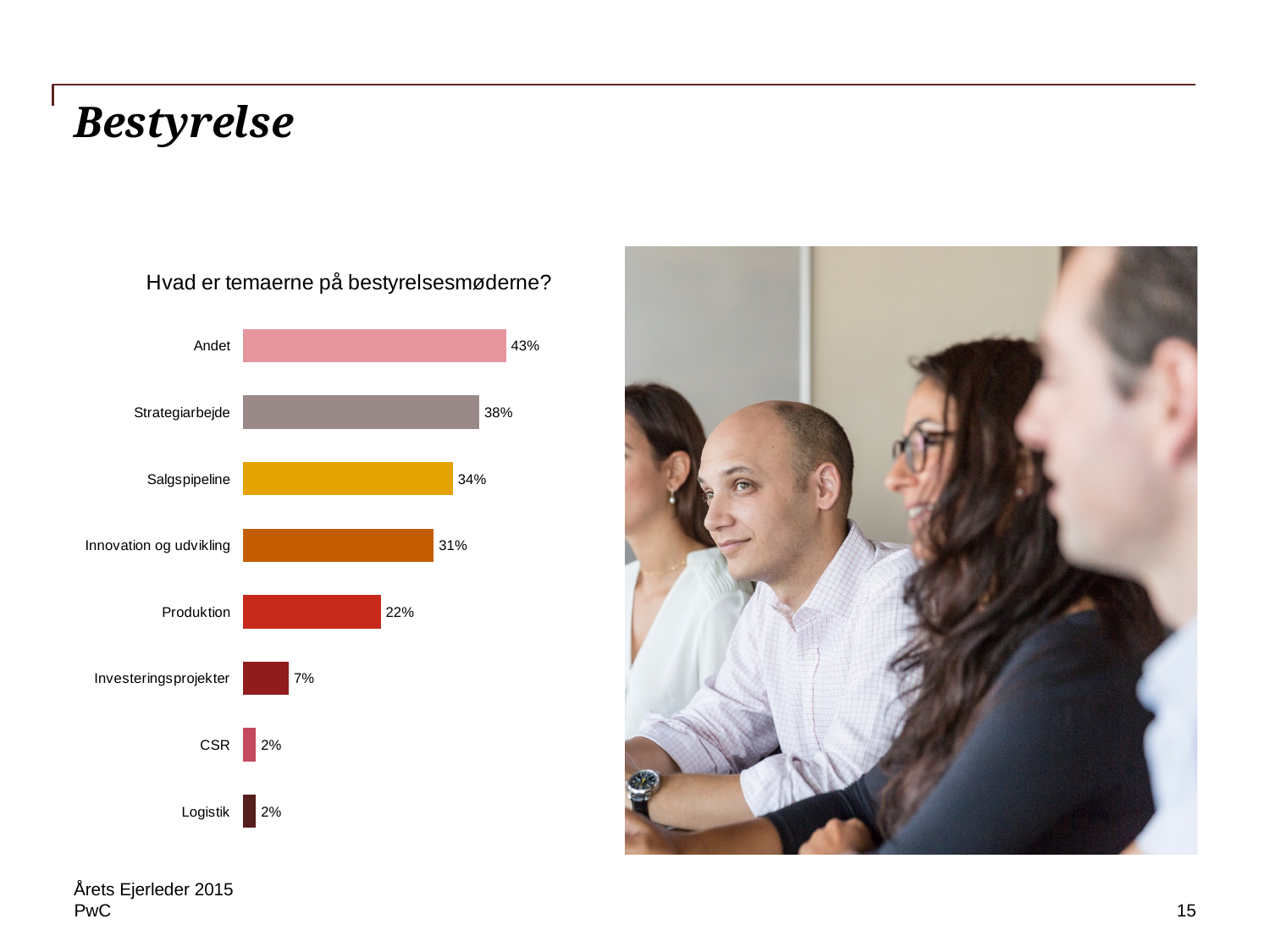
Which category has the highest value? Andet Which two categories share the lowest value of 2%? CSR and Logistik What is the difference between the values for Innovation og udvikling and Produktion? 9% How many categories are shown in the chart? 8 What kind of chart is shown on the slide? Bar chart What is the title of the chart? Hvad er temaerne på bestyrelsesmøderne? What is the value for Salgspipeline? 34% What is the difference between the values for Andet and Salgspipeline? 9% What is the value for Strategiarbejde? 38% What is the value for Produktion? 22% Which is larger, the value for Salgspipeline or the value for Innovation og udvikling? Salgspipeline What is the value for Investeringsprojekter? 7%